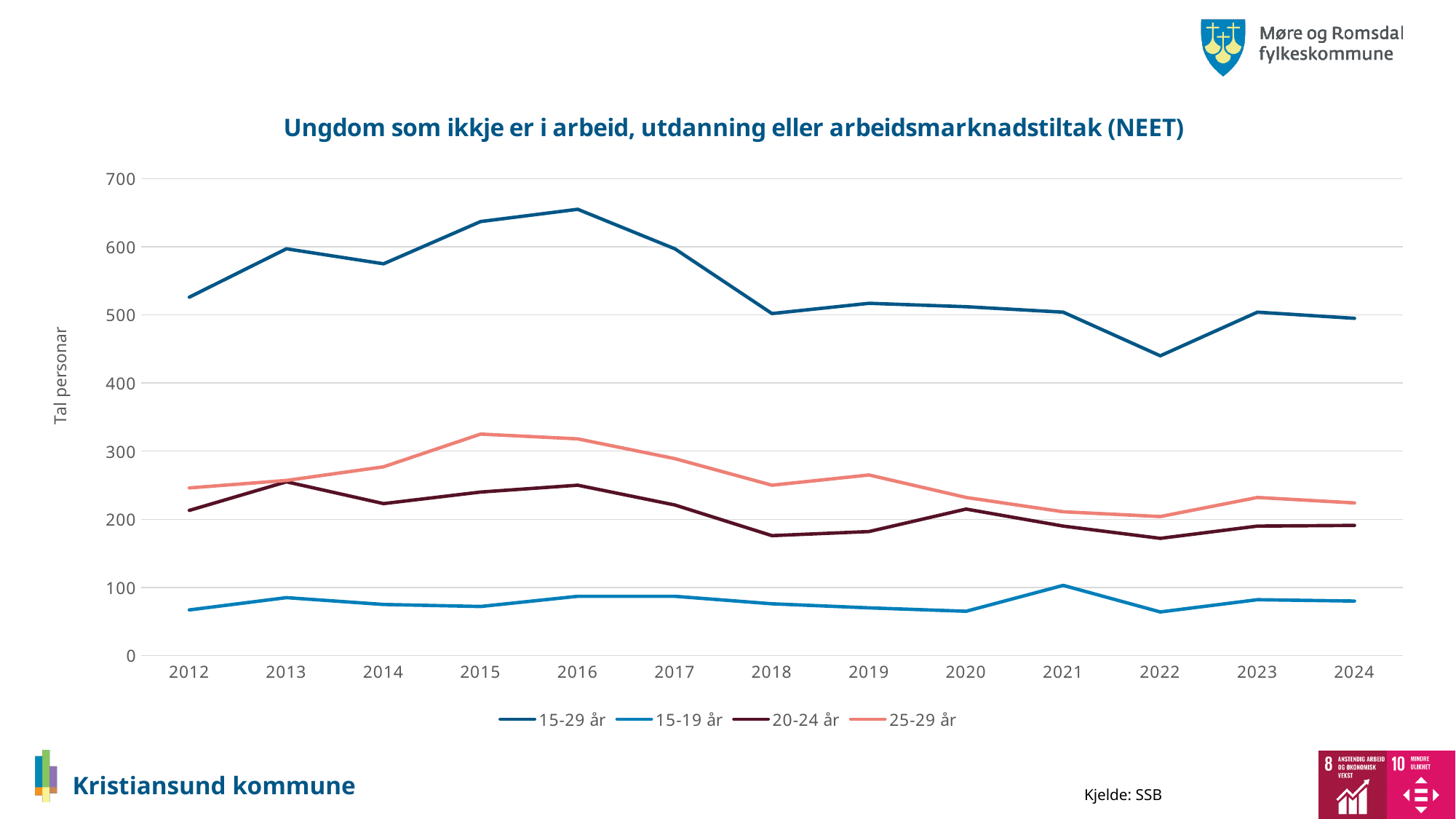
Is the value for 15-29 år in 2022 greater or less than 500? less In which year is the value for 15-29 år highest? 2016 How many years are shown on the x axis? 13 What kind of chart is shown on the slide? line chart In which year is the value for 15-29 år lowest? 2022 Is the value for 25-29 år in 2015 greater or less than 300? greater How many series does the legend list? 4 Is the value for 15-29 år in 2016 greater or less than 600? greater In 2016, which series has the larger value: 20-24 år or 25-29 år? 25-29 år Does the value for 15-29 år rise or fall from 2016 to 2018? fall In which year is the value for 15-19 år highest? 2021